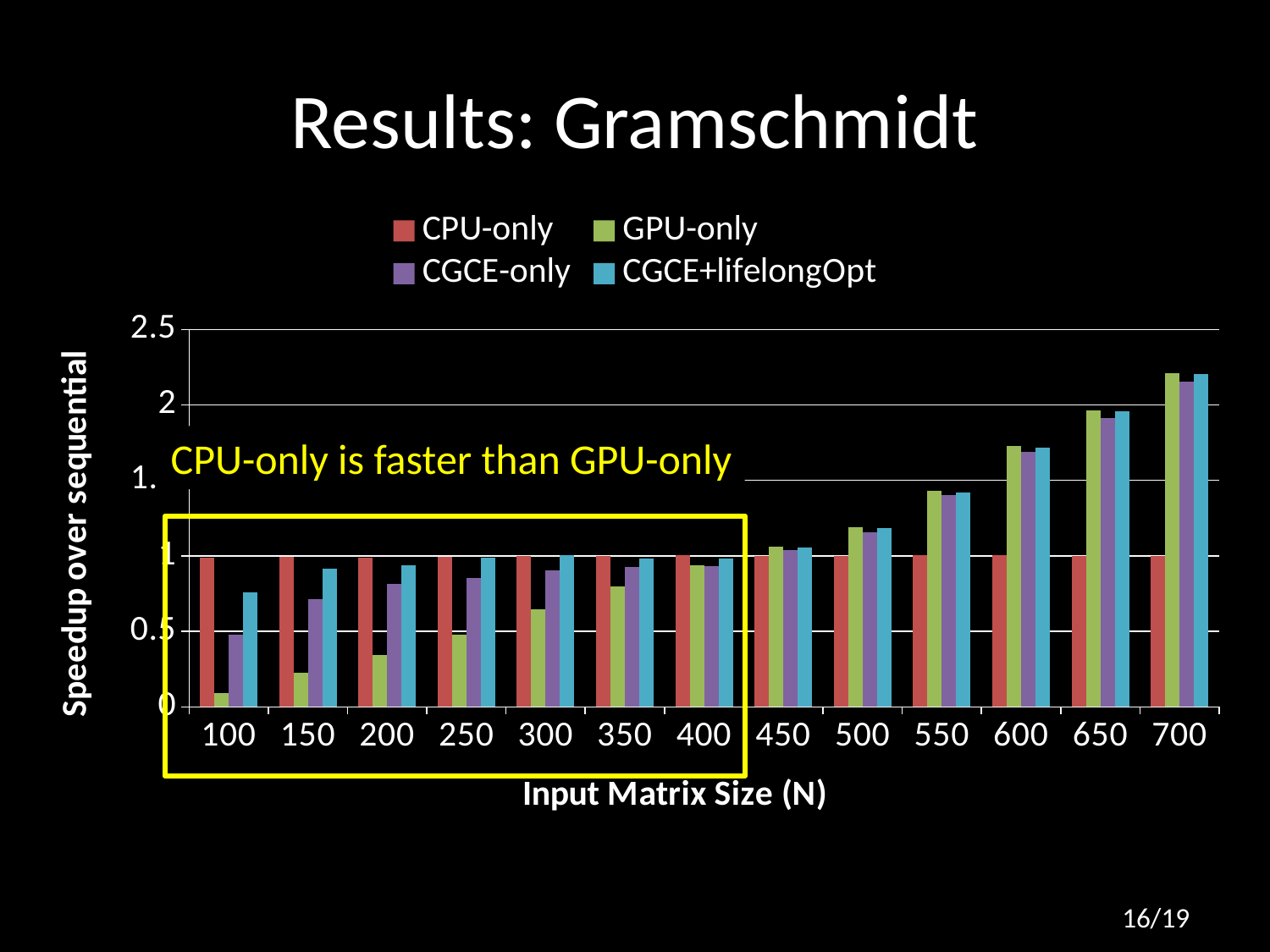
What kind of chart is shown on the slide? bar chart How many series does the legend list? 4 What is the title of the y axis? Speedup over sequential Is the GPU-only value at input matrix size 100 greater or less than 0.5? less At which input matrix size is the GPU-only speedup highest? 700 Is the CGCE+lifelongOpt value at input matrix size 600 greater or less than 1.5? greater Is the GPU-only value at input matrix size 700 greater or less than 2? greater How many input matrix sizes are shown along the x axis? 13 Do the GPU-only values rise or fall as the input matrix size increases? rise At input matrix size 100, which is larger: CPU-only or GPU-only? CPU-only At which input matrix size is the GPU-only speedup lowest? 100